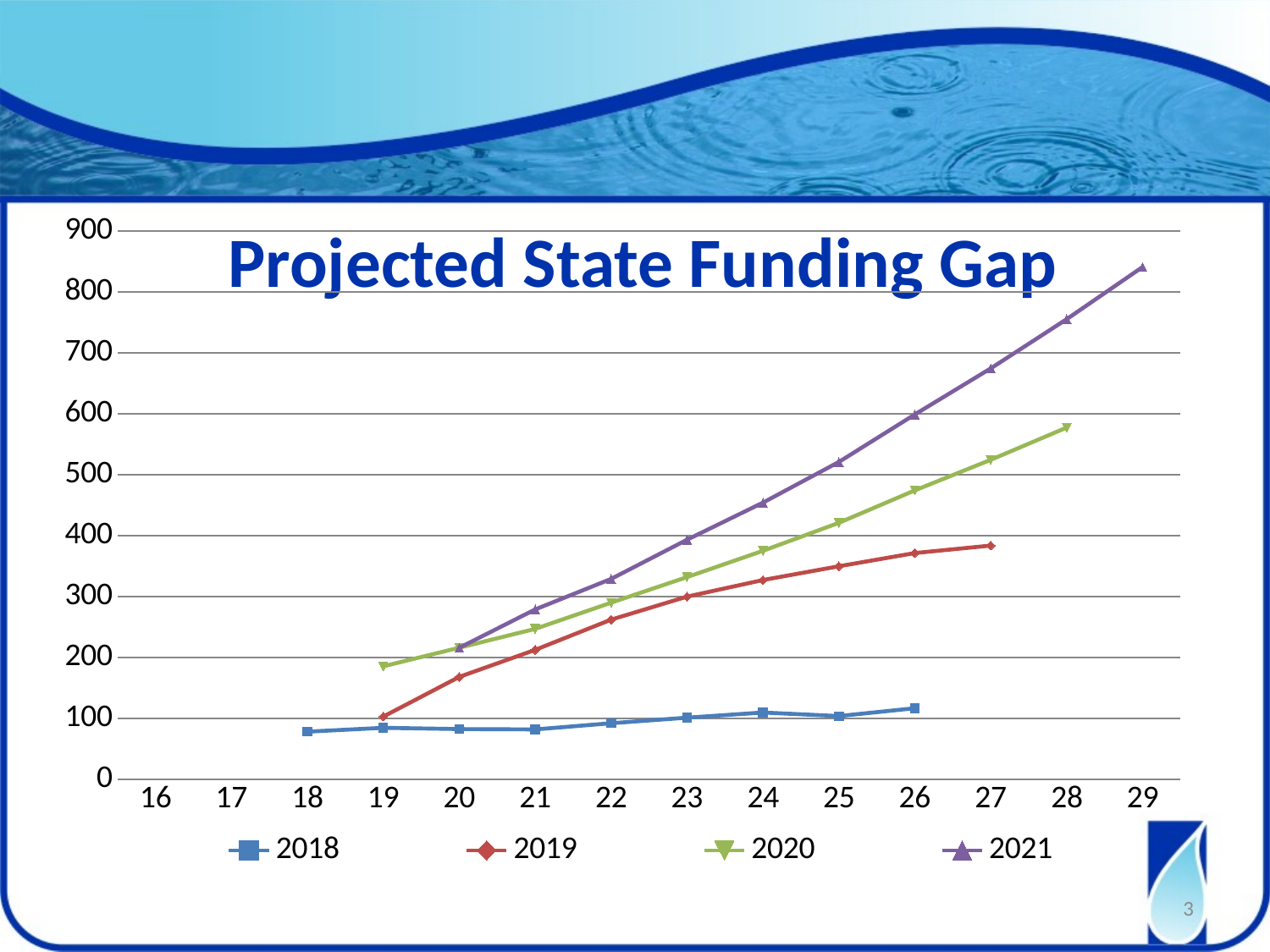
What is the title of the chart? Projected State Funding Gap Is the value for the 2020 series at 28 greater or less than 500? greater Which series stays lowest across the chart? 2018 Which series reaches the highest value on the chart? 2021 Is the value for the 2021 series at 29 greater or less than 800? greater How many series does the legend list? 4 What kind of chart is shown on the slide? line chart How many data points does the 2021 series have? 10 Is the value for the 2018 series at 18 greater or less than 100? less Does the 2021 series rise or fall as the x axis increases? rise How many tick labels are shown along the x axis? 14 At 28, which series has the larger value, 2021 or 2020? 2021